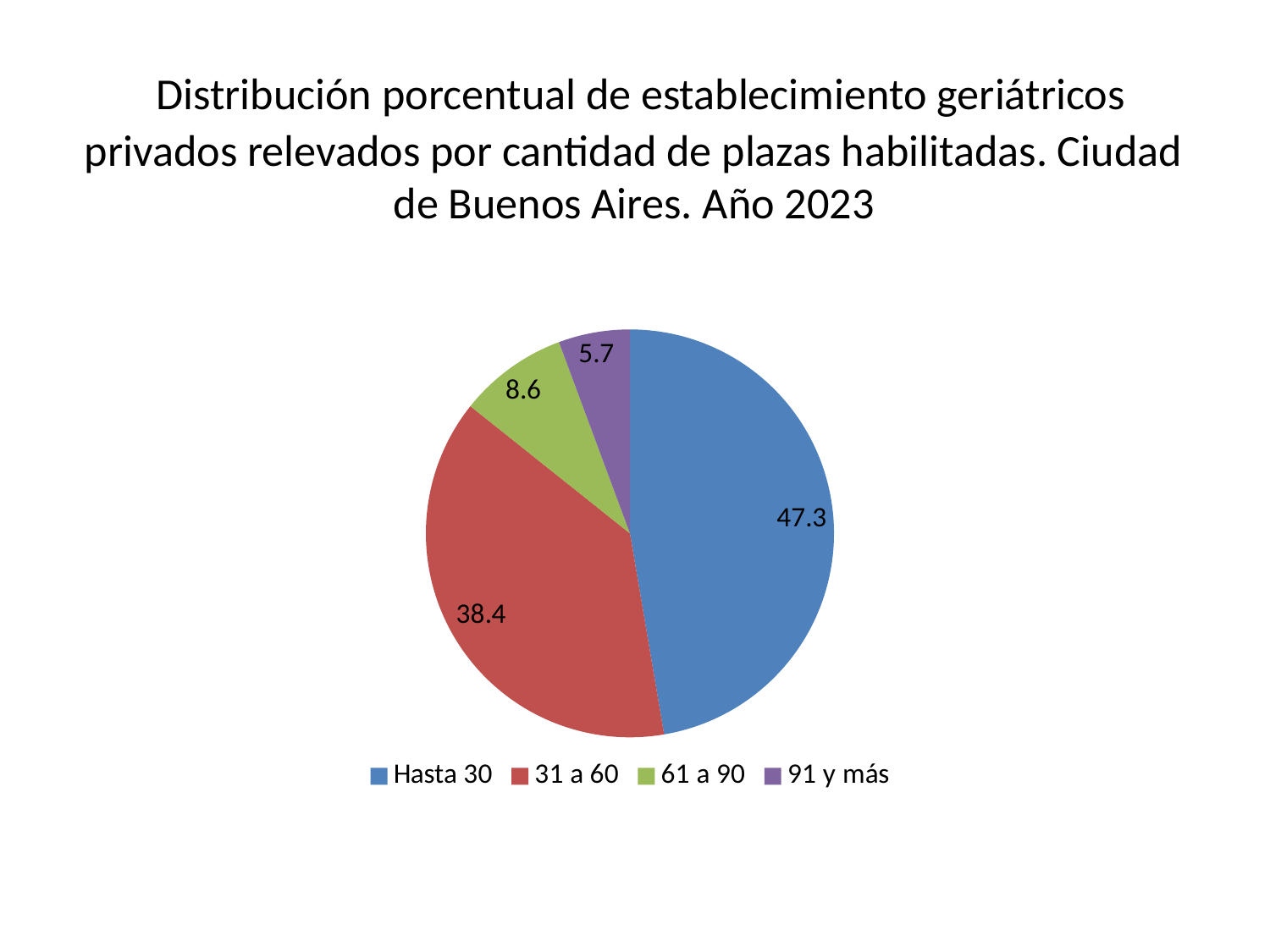
What is the value for the '61 a 90' slice? 8.6 What is the value for the 'Hasta 30' slice? 47.3 Which category has the smallest slice? 91 y más How many categories does the pie chart show? 4 Which category has the largest slice? Hasta 30 What kind of chart is shown on the slide? pie chart What is the difference between the values for 'Hasta 30' and '31 a 60'? 8.9 What is the value for the '91 y más' slice? 5.7 Which is larger, the value for '61 a 90' or the value for '91 y más'? 61 a 90 What colour is the '31 a 60' slice? red What year does the chart title refer to? 2023 What is the value for the '31 a 60' slice? 38.4